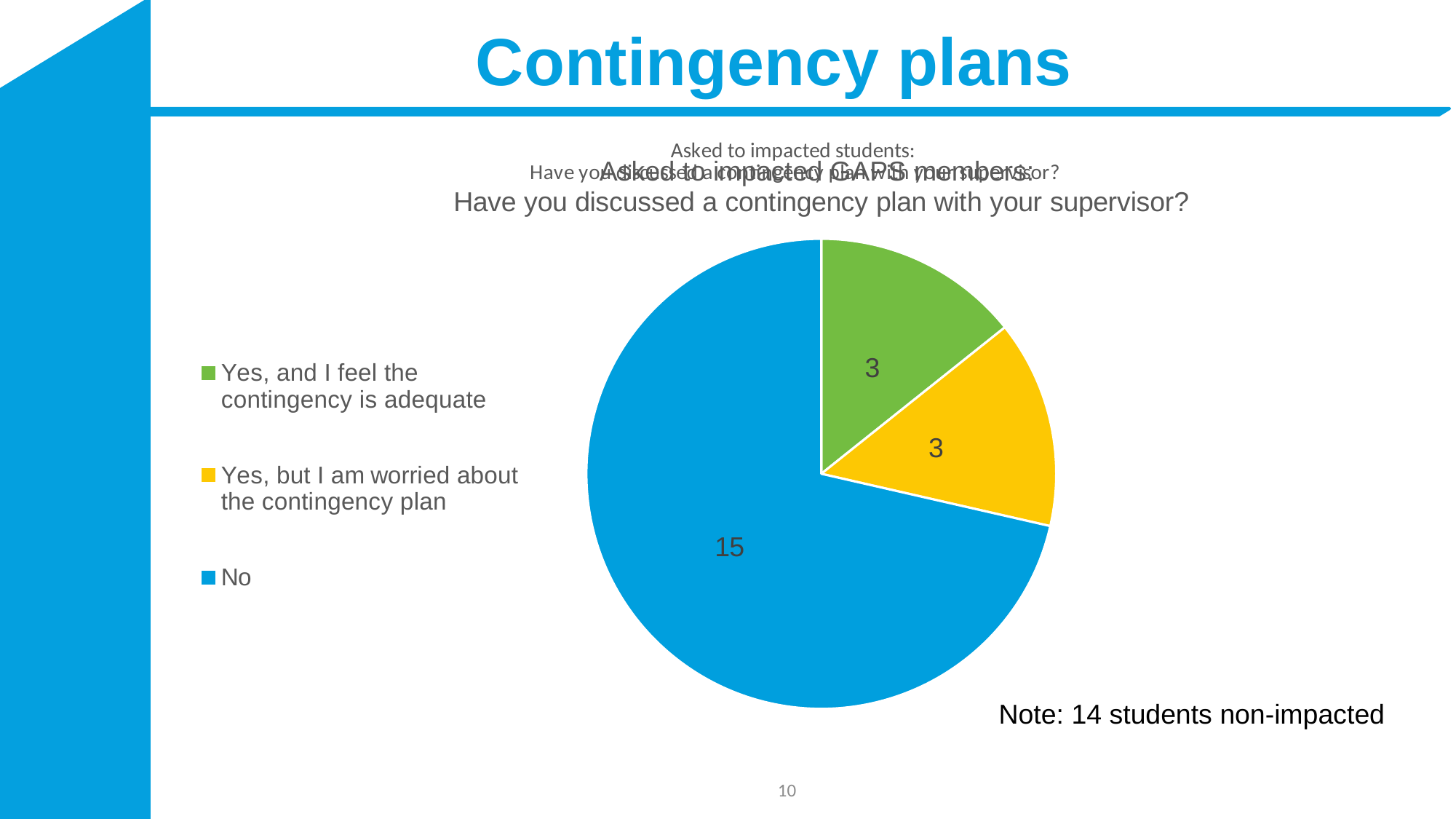
What is the total of all slices in the pie chart? 21 How many slices does the pie chart have? 3 What is the value of the 'Yes, and I feel the contingency is adequate' slice? 3 What type of chart is shown on the slide? pie chart What colour is the 'No' slice in the pie chart? blue What question does the pie chart's title say was asked? Have you discussed a contingency plan with your supervisor? What is the value of the 'No' slice in the pie chart? 15 What is the difference between the 'No' slice and the 'Yes, and I feel the contingency is adequate' slice? 12 Which response has the largest slice in the pie chart? No Which is larger: the 'No' slice or the 'Yes, but I am worried about the contingency plan' slice? No What is the value of the 'Yes, but I am worried about the contingency plan' slice? 3 What fraction of the total responses does the 'No' slice represent? 15 of 21